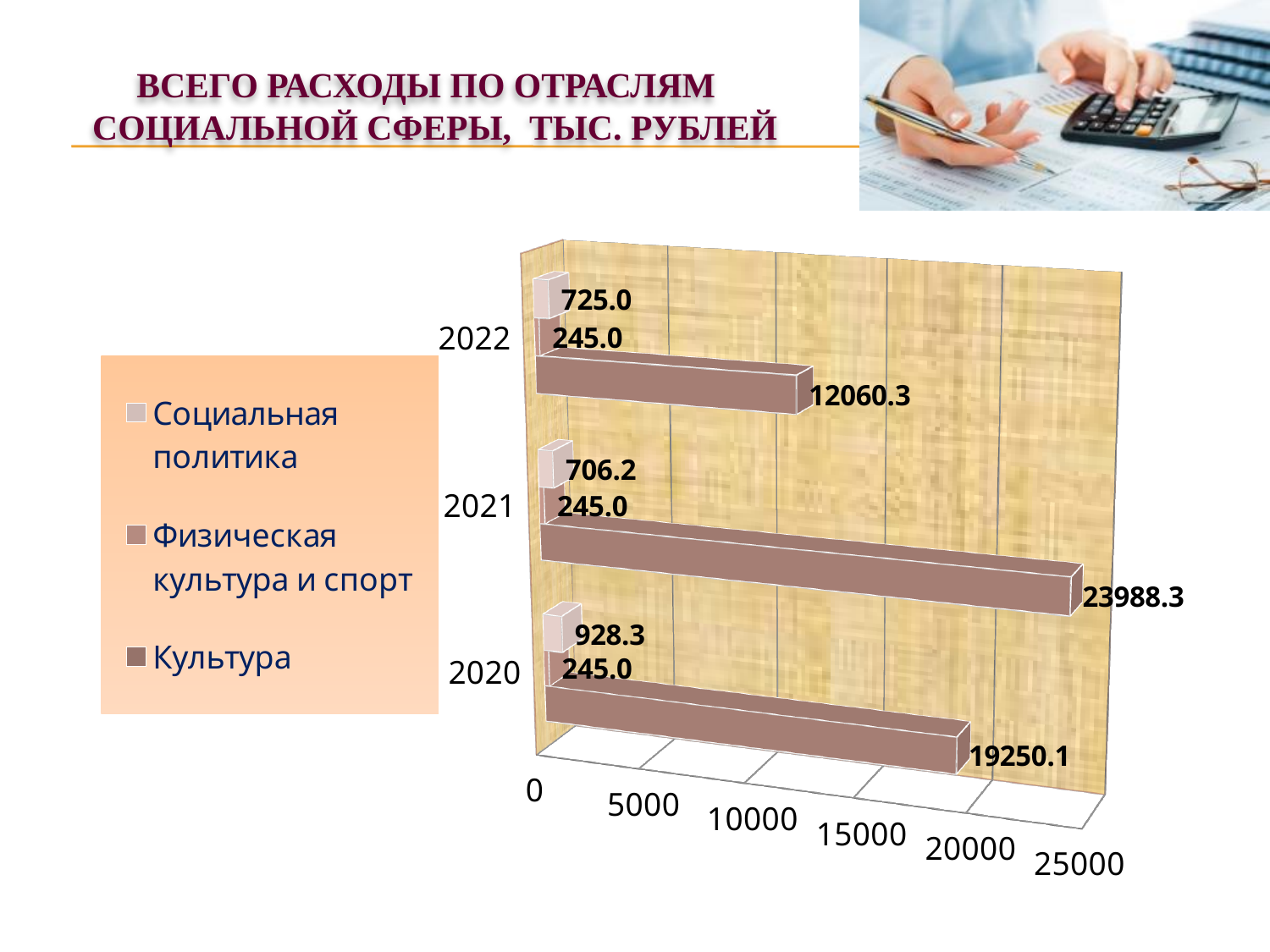
Which is larger: Социальная политика in 2022 or Социальная политика in 2020? Социальная политика in 2020 What is the title of the chart? ВСЕГО РАСХОДЫ ПО ОТРАСЛЯМ СОЦИАЛЬНОЙ СФЕРЫ, ТЫС. РУБЛЕЙ How many series does the legend list? 3 What is the value for Физическая культура и спорт in 2022? 245.0 In which year is the value for Культура the highest? 2021 What is the value for Культура in 2021? 23988.3 How many years are shown on the chart? 3 What is the value for Социальная политика in 2020? 928.3 What is the value for Культура in 2022? 12060.3 What kind of chart is shown on the slide? bar chart In which year is the value for Социальная политика the lowest? 2021 What is the difference between the Культура values for 2021 and 2020? 4738.2